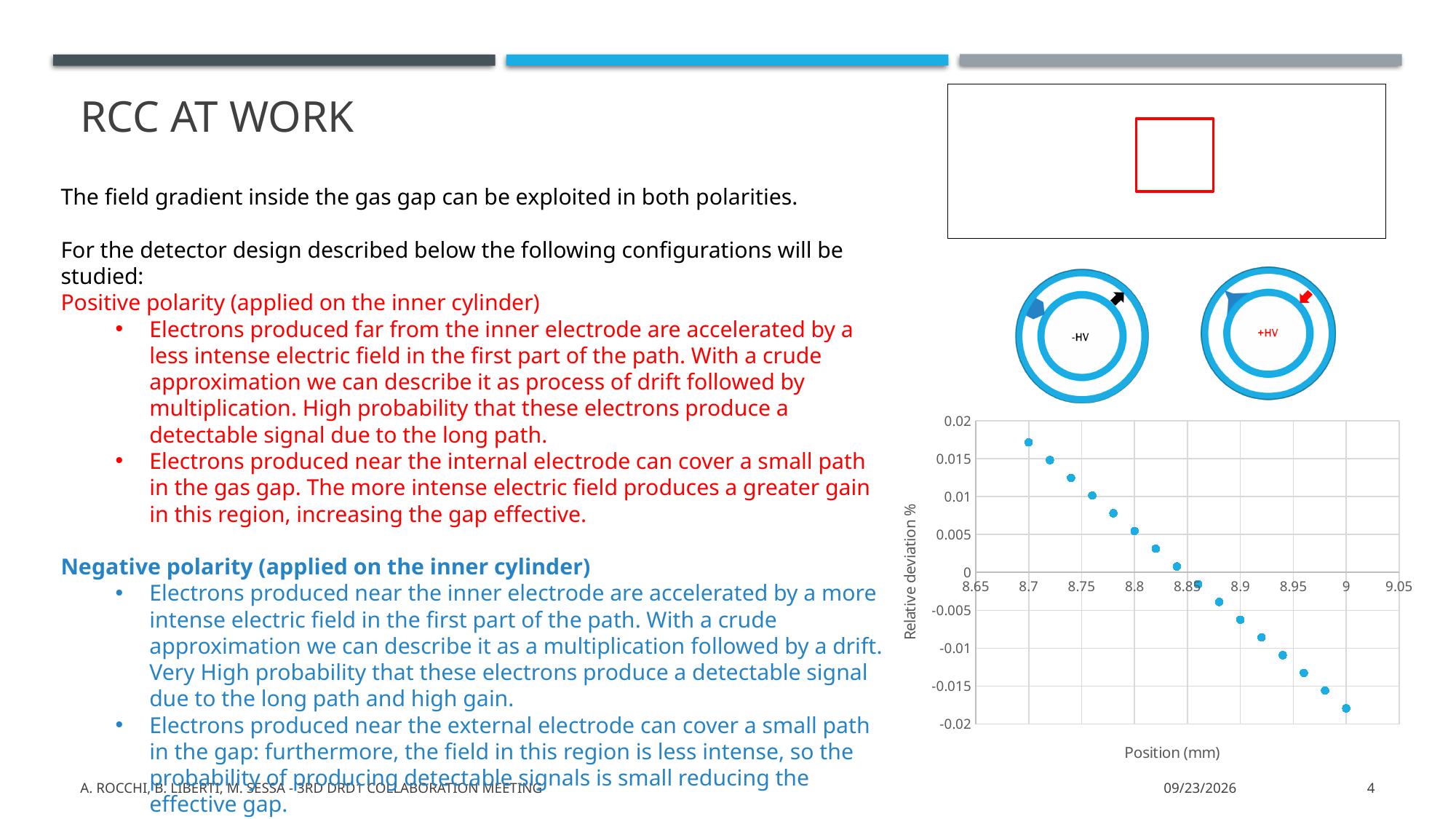
What is the title of the x axis of the chart? Position (mm) Is the relative deviation at position 8.9 mm greater or less than 0? less Is the relative deviation at position 8.8 mm greater or less than 0? greater What kind of chart is shown on the slide? scatter chart Is the relative deviation at position 8.7 mm greater or less than 0.015? greater At which position (mm) is the relative deviation highest? 8.7 How many data points are plotted in the chart? 16 What is the title of the y axis of the chart? Relative deviation % Which has the larger relative deviation: the point at 8.7 mm or the point at 9 mm? 8.7 mm At which position (mm) is the relative deviation lowest? 9 Do the plotted values rise or fall as position increases along the x axis? fall